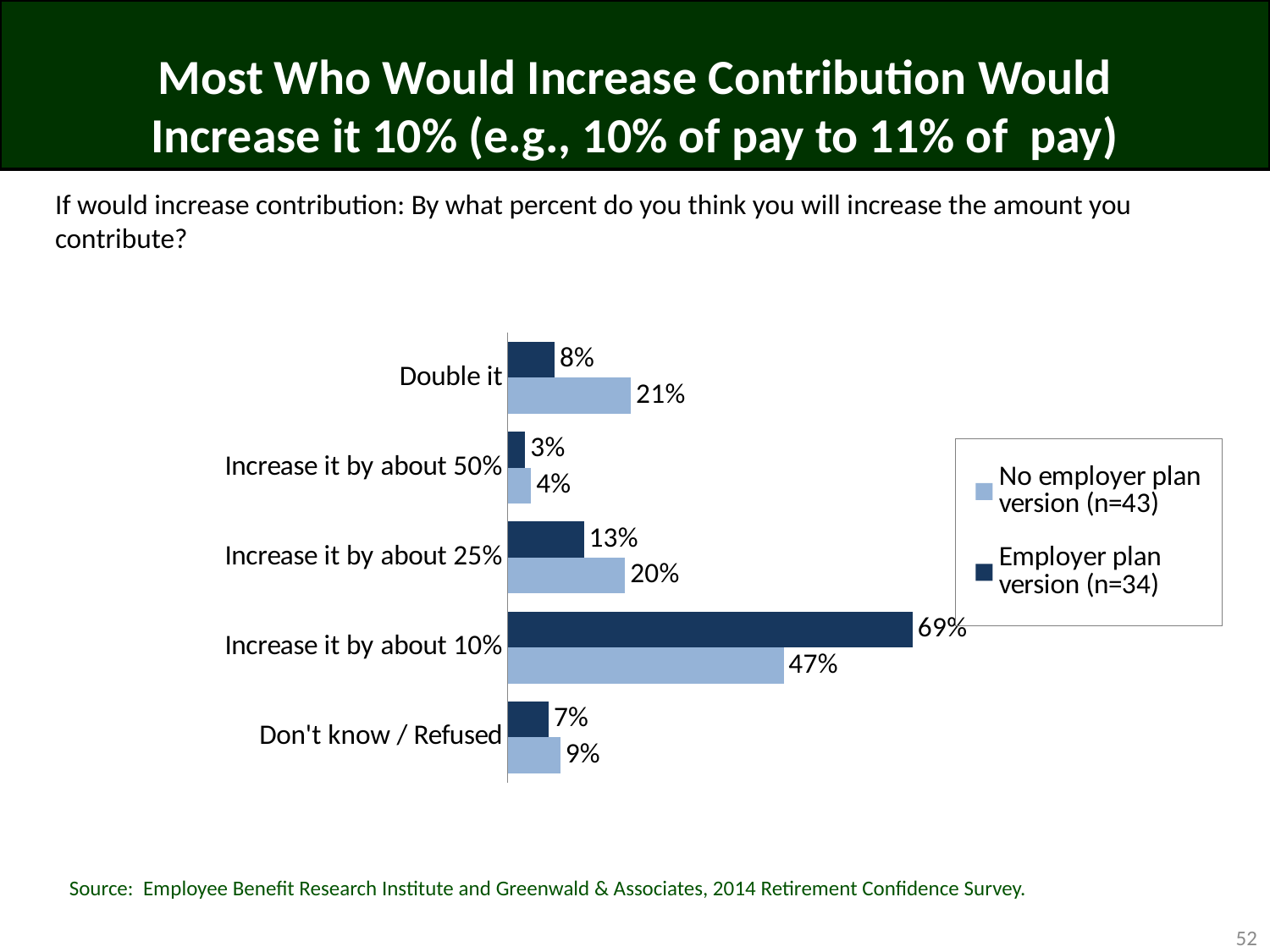
How many series does the legend list? 2 What is the value for "Double it" in the No employer plan version (n=43) series? 21% What colour are the bars for the Employer plan version (n=34) series? Dark blue What is the value for "Increase it by about 25%" in the Employer plan version (n=34) series? 13% What is the value for "Don't know / Refused" in the No employer plan version (n=43) series? 9% Which category has the lowest value in the Employer plan version (n=34) series? Increase it by about 50% How many categories are shown on the chart? 5 Which category has the highest value in the No employer plan version (n=43) series? Increase it by about 10% What is the value for "Increase it by about 10%" in the Employer plan version (n=34) series? 69% What is the difference between the Employer plan version and No employer plan version values for "Increase it by about 10%"? 22 percentage points What kind of chart is shown on the slide? Bar chart For "Double it", which series has the larger value: No employer plan version (n=43) or Employer plan version (n=34)? No employer plan version (n=43)